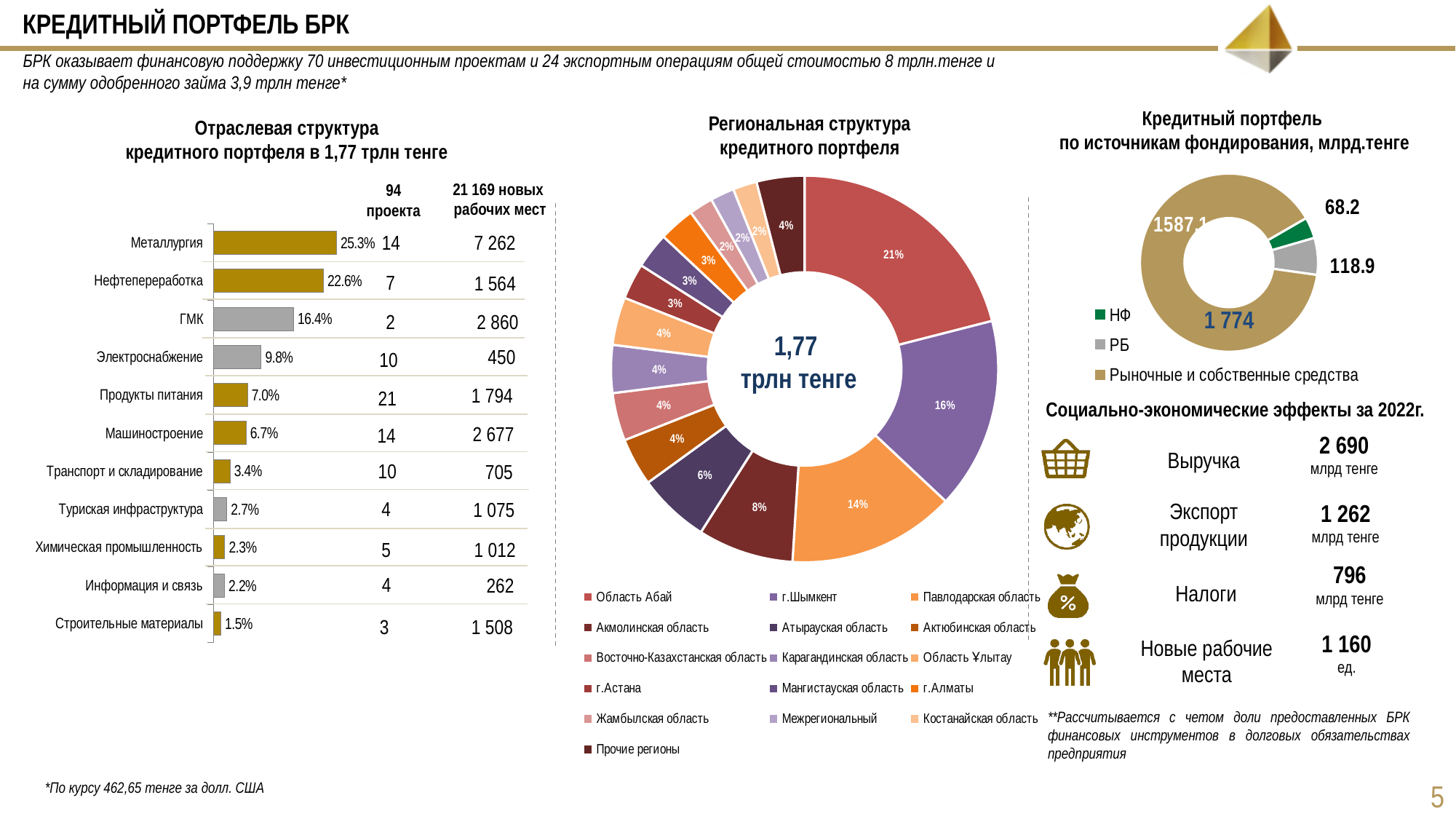
What kind of chart is 'Отраслевая структура кредитного портфеля'? Bar chart In the bar chart 'Отраслевая структура кредитного портфеля', which category has the highest value? Металлургия In the bar chart 'Отраслевая структура кредитного портфеля', which is larger: Продукты питания or Машиностроение? Продукты питания In the chart 'Кредитный портфель по источникам фондирования', what is the difference between РБ and НФ? 50.7 In the bar chart 'Отраслевая структура кредитного портфеля', what is the value for Металлургия? 25.3% In the donut chart 'Региональная структура кредитного портфеля', what share does Область Абай have? 21% How many entries does the legend of the chart 'Региональная структура кредитного портфеля' list? 16 In the bar chart 'Отраслевая структура кредитного портфеля', what is the difference between Нефтепереработка and ГМК? 6.2% In the bar chart 'Отраслевая структура кредитного портфеля', what is the value for Электроснабжение? 9.8% How many categories are shown in the bar chart 'Отраслевая структура кредитного портфеля'? 11 In the bar chart 'Отраслевая структура кредитного портфеля', which category has the lowest value? Строительные материалы In the chart 'Кредитный портфель по источникам фондирования', what is the value for РБ? 118.9